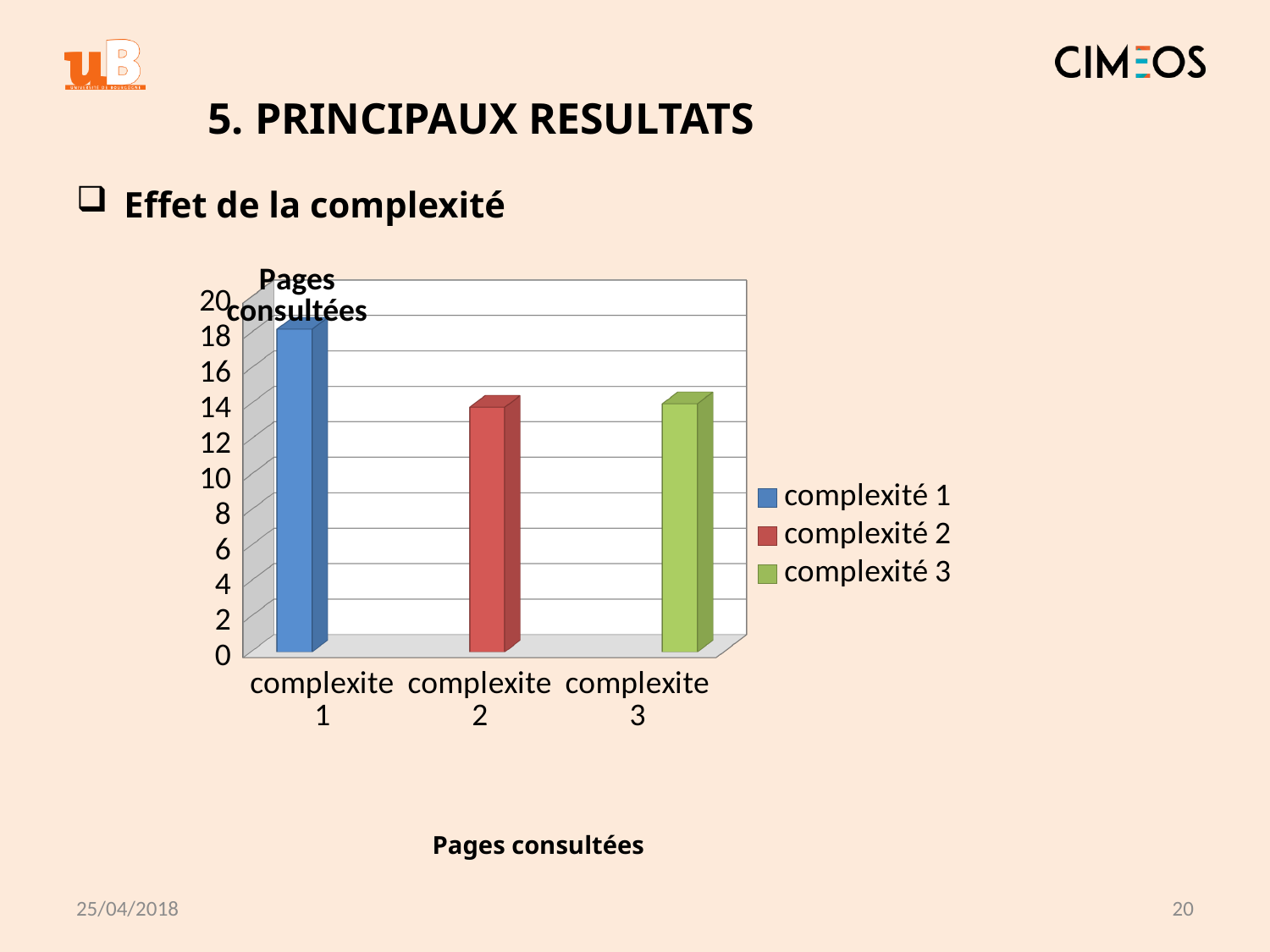
Is the value for complexite 2 greater or less than 16? less How many categories are shown on the x axis of the chart? 3 What colour is the bar for complexité 2 according to the legend? red Is the value for complexite 1 greater or less than 20? less Is the value for complexite 1 greater or less than 16? greater How many entries does the chart's legend list? 3 Which is larger, the value for complexite 1 or the value for complexite 2? complexite 1 What is the title of the chart? Pages consultées Which is larger, the value for complexite 3 or the value for complexite 1? complexite 1 What kind of chart is shown on the slide? bar chart Which category has the highest value in the chart? complexite 1